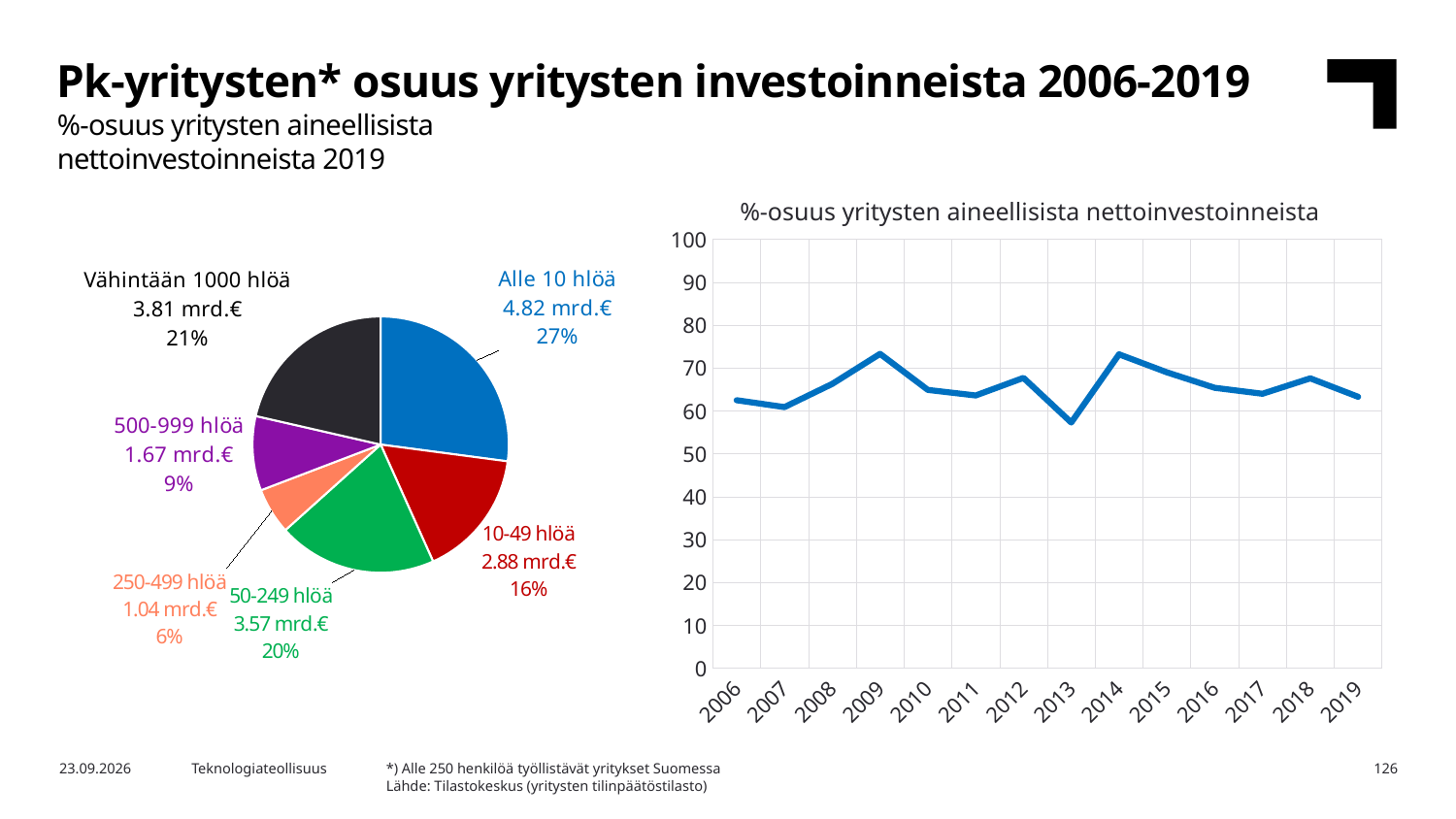
What kind of chart is the chart on the left of the slide? pie chart What kind of chart is the chart titled '%-osuus yritysten aineellisista nettoinvestoinneista' on the right? line chart In the pie chart on the left, what is the value in mrd.€ for 'Alle 10 hlöä'? 4.82 mrd.€ In the line chart on the right, is the value for 2009 greater or less than 70? greater In the pie chart on the left, what share does '50-249 hlöä' have? 20% In the line chart on the right, which year has the lowest value? 2013 How many slices does the pie chart on the left have? 6 In the line chart on the right, how many years are shown on the x axis? 14 In the pie chart on the left, which is larger: the value for '10-49 hlöä' or for '50-249 hlöä'? 50-249 hlöä In the pie chart on the left, what is the difference in mrd.€ between 'Vähintään 1000 hlöä' and '500-999 hlöä'? 2.14 mrd.€ In the pie chart on the left, which category has the largest share? Alle 10 hlöä In the pie chart on the left, which category has the smallest share? 250-499 hlöä